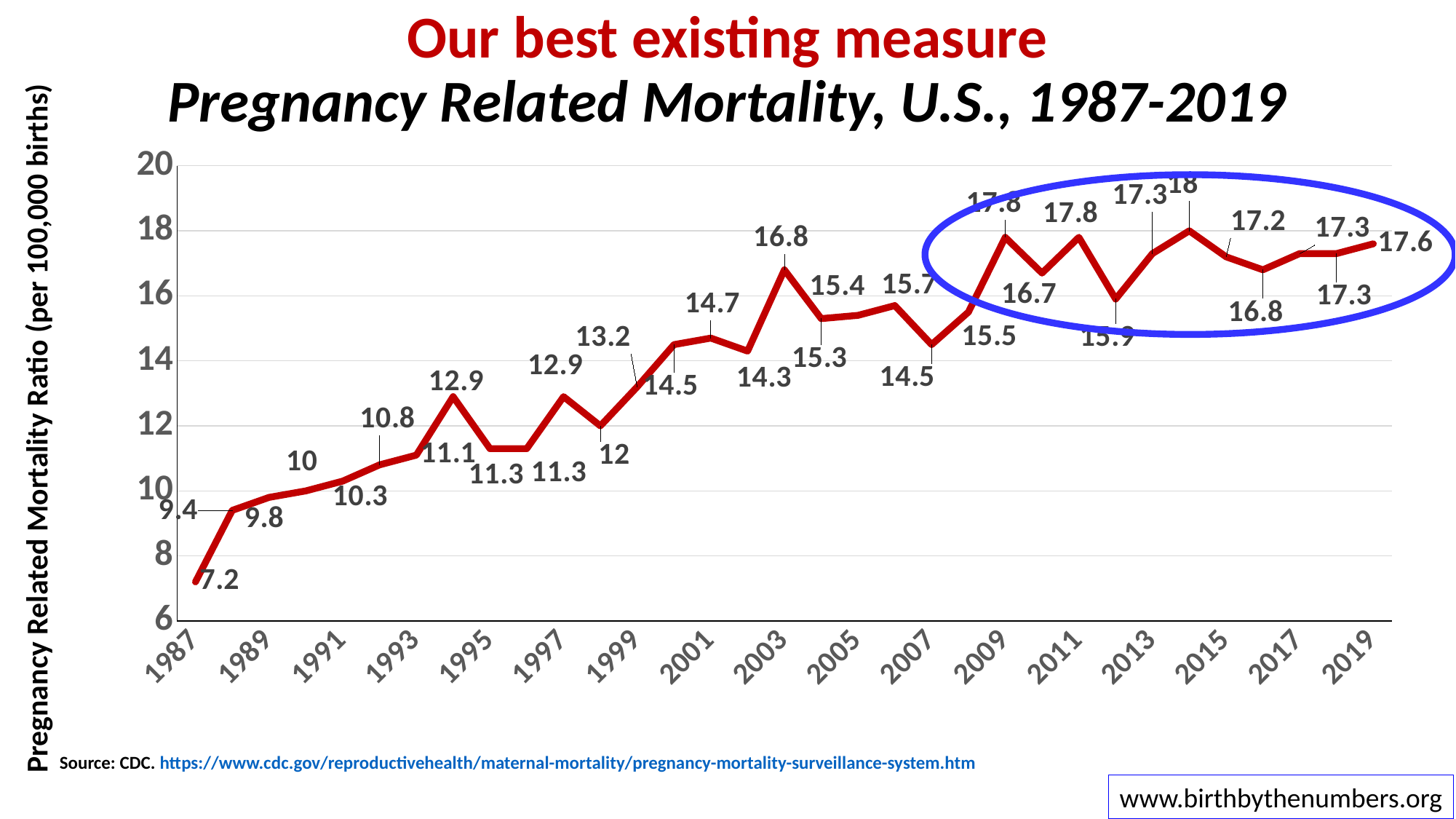
Is the value for 1991 greater or less than 12? less By how much did the pregnancy related mortality ratio increase from 1987 to 2019? 10.4 What is the label on the vertical axis? Pregnancy Related Mortality Ratio (per 100,000 births) What is the highest value plotted on the line? 18 Which year has the higher value, 2003 or 2007? 2003 What is the pregnancy related mortality ratio for 1987? 7.2 What value is plotted for 2009? 17.8 What is the pregnancy related mortality ratio for 2019? 17.6 What value is plotted for 2003? 16.8 What kind of chart is shown on the slide? line chart Which year has the lowest pregnancy related mortality ratio? 1987 Overall, do the values rise or fall from 1987 to 2019? rise